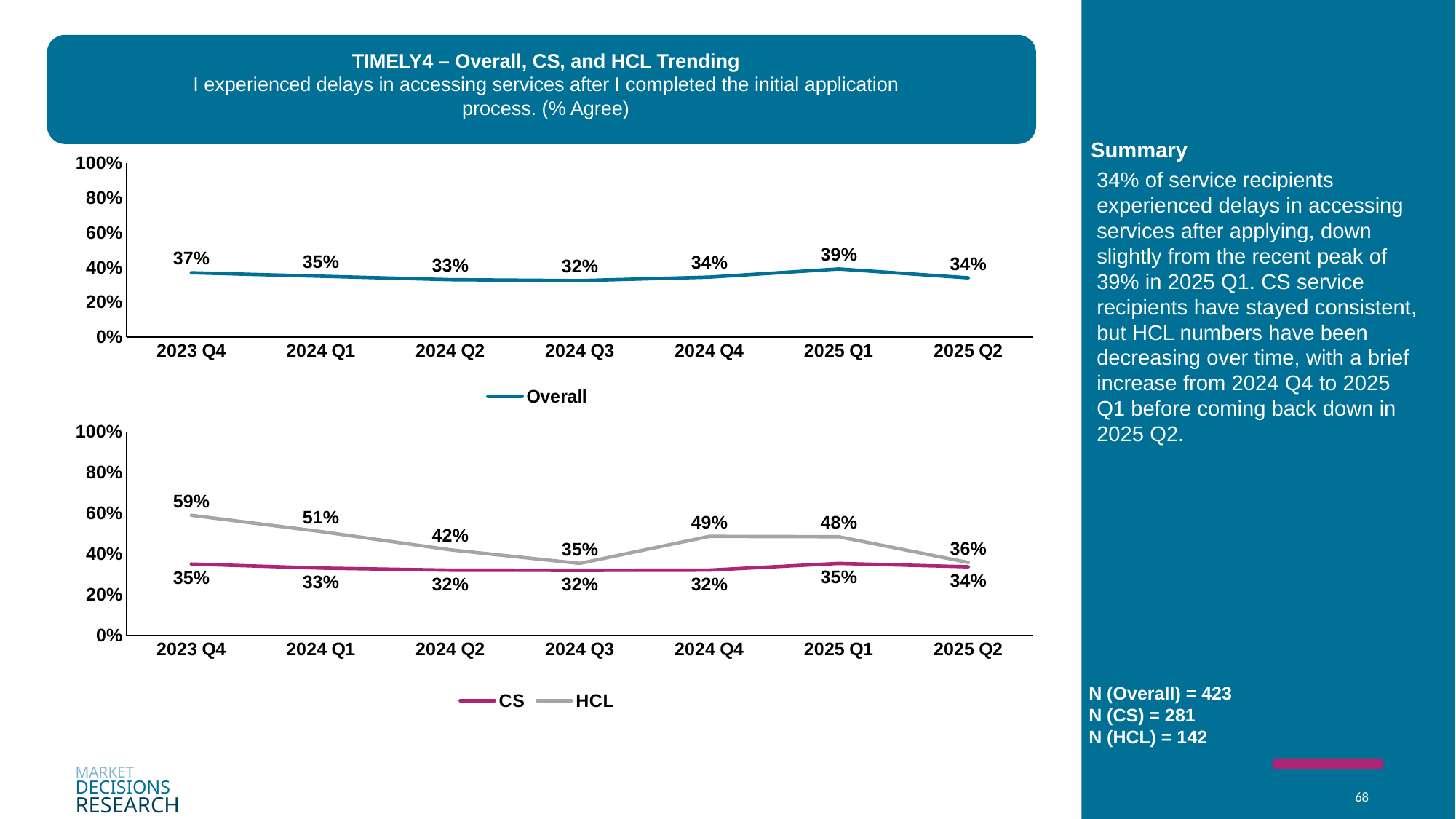
In the bottom chart, which is larger in 2024 Q1: the CS value or the HCL value? HCL In the bottom chart, what is the CS value for 2025 Q1? 35% In the top chart (Overall), what is the difference between the 2023 Q4 value and the 2024 Q3 value? 5% In the top chart (Overall), what is the value for 2025 Q1? 39% How many series does the legend of the bottom chart list? 2 In the bottom chart, what is the difference between the HCL and CS values in 2023 Q4? 24% In the bottom chart, does the HCL value rise or fall from 2023 Q4 to 2024 Q3? Fall How many quarters are plotted on the x axis of the bottom chart? 7 In the bottom chart, what is the HCL value for 2024 Q4? 49% In the bottom chart, in which quarter is the HCL value highest? 2023 Q4 What kind of chart is the top chart? Line chart In the top chart (Overall), which quarter has the lowest value? 2024 Q3